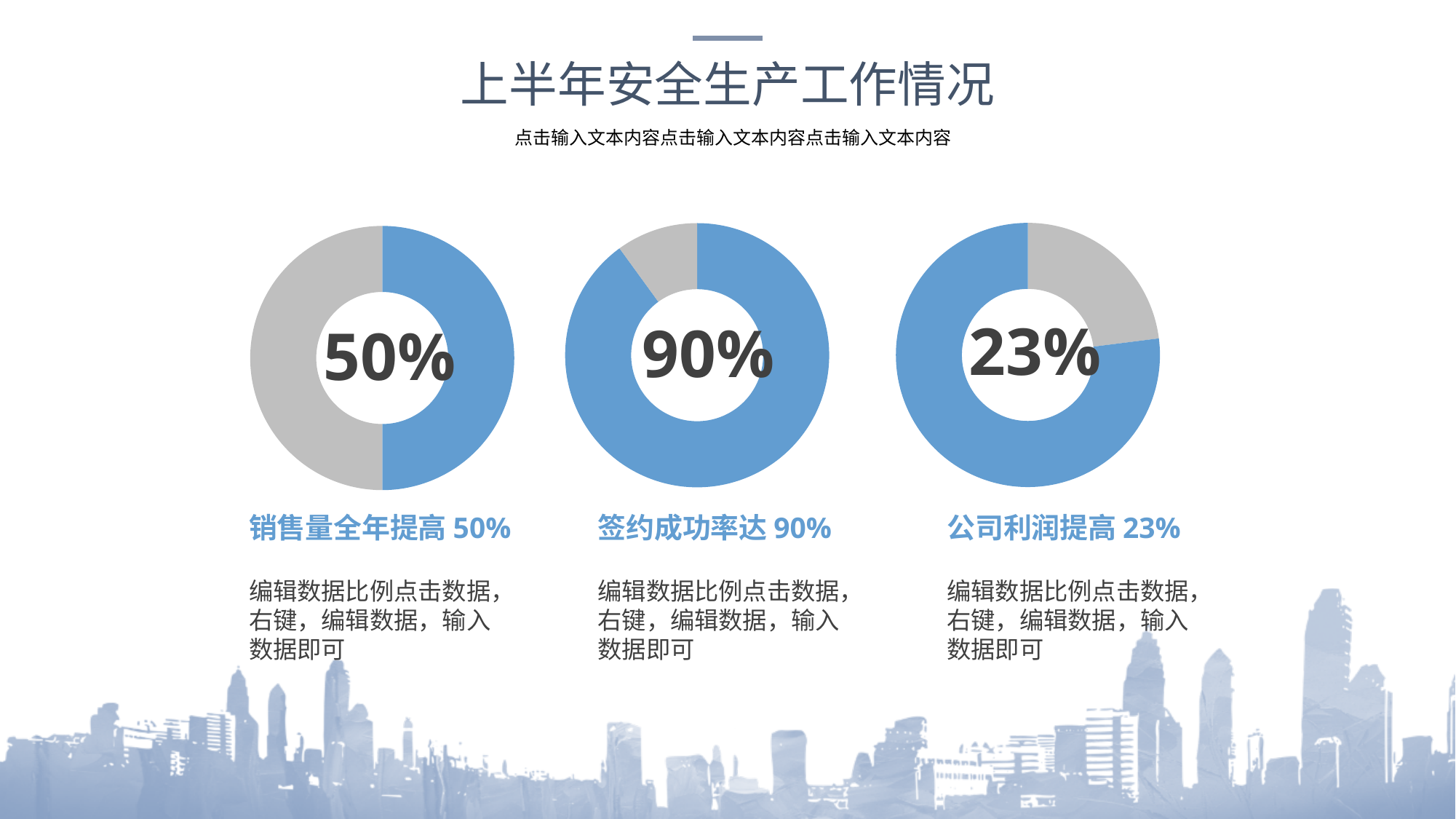
What is the difference between the percentage in the middle chart (90%) and the left chart (50%)? 40% Which is larger, the percentage for 销售量全年提高 or the percentage for 公司利润提高? 销售量全年提高 Is the value shown in the right donut chart (公司利润提高) greater or less than 50%? less What is the difference between the percentage in the left chart (50%) and the right chart (23%)? 27% How many donut charts are shown on the slide? 3 Which of the three donut charts shows the lowest percentage? 公司利润提高 23% What kind of chart is used to display the three percentages on the slide? Donut (pie) chart What colour is the highlighted slice in the left donut chart? Blue What value is shown in the centre of the left donut chart (销售量全年提高)? 50% What value is shown in the centre of the right donut chart (公司利润提高)? 23% Which of the three donut charts shows the highest percentage? 签约成功率达 90% What value is shown in the centre of the middle donut chart (签约成功率达)? 90%